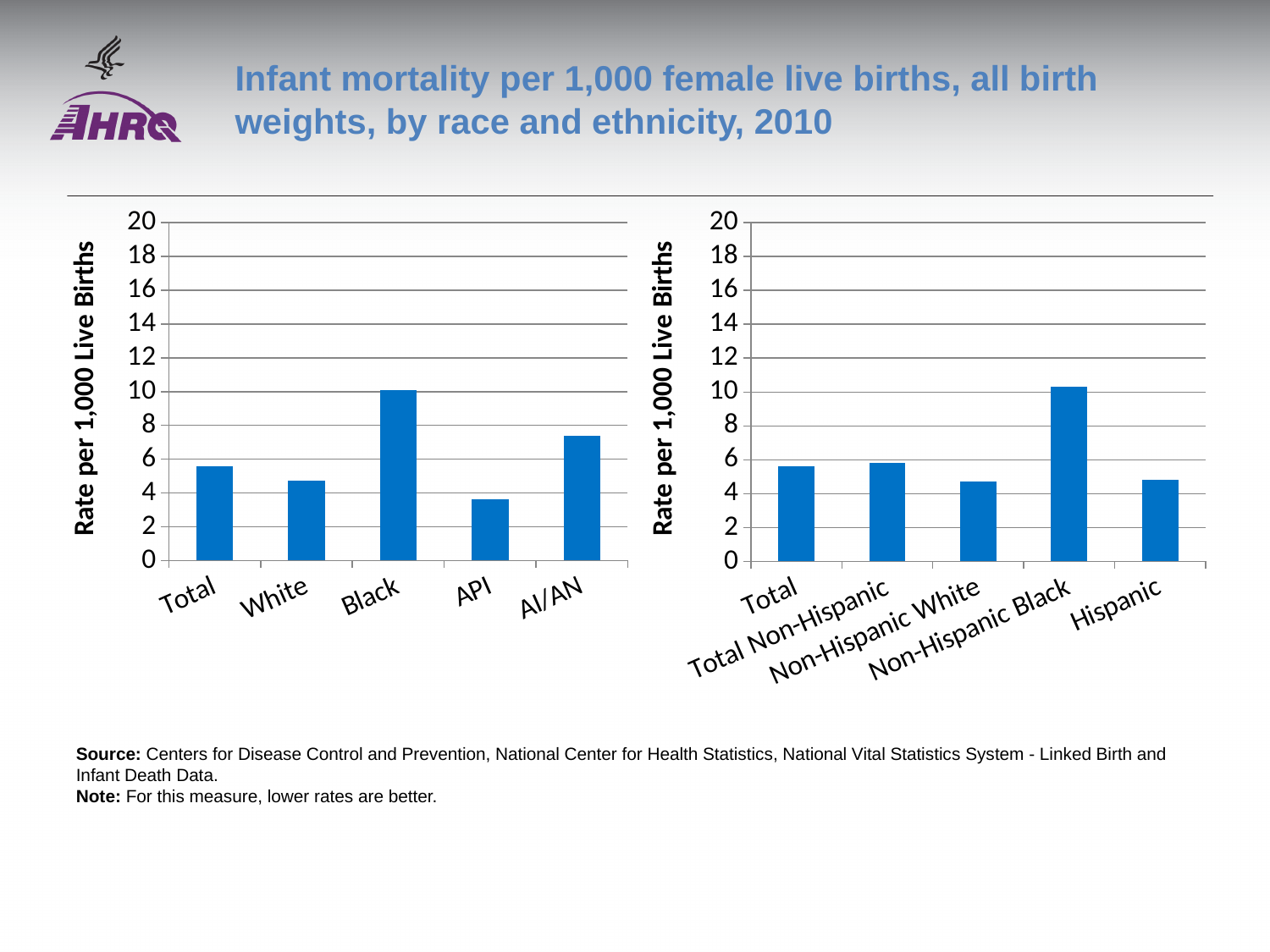
In the left chart, which category has the lowest infant mortality rate? API What is the y-axis title of the left chart? Rate per 1,000 Live Births In the left chart, which category has the highest infant mortality rate? Black In the right chart, is the value for Non-Hispanic White greater or less than 6? less In the left chart, is the value for API greater or less than 4? less How many categories are shown in the right chart? 5 How many categories are shown in the left chart? 5 In the left chart, which is larger, the value for AI/AN or the value for White? AI/AN In the left chart, is the value for Black greater or less than 8? greater In the right chart, which category has the highest infant mortality rate? Non-Hispanic Black What kind of chart is the left chart? Bar chart